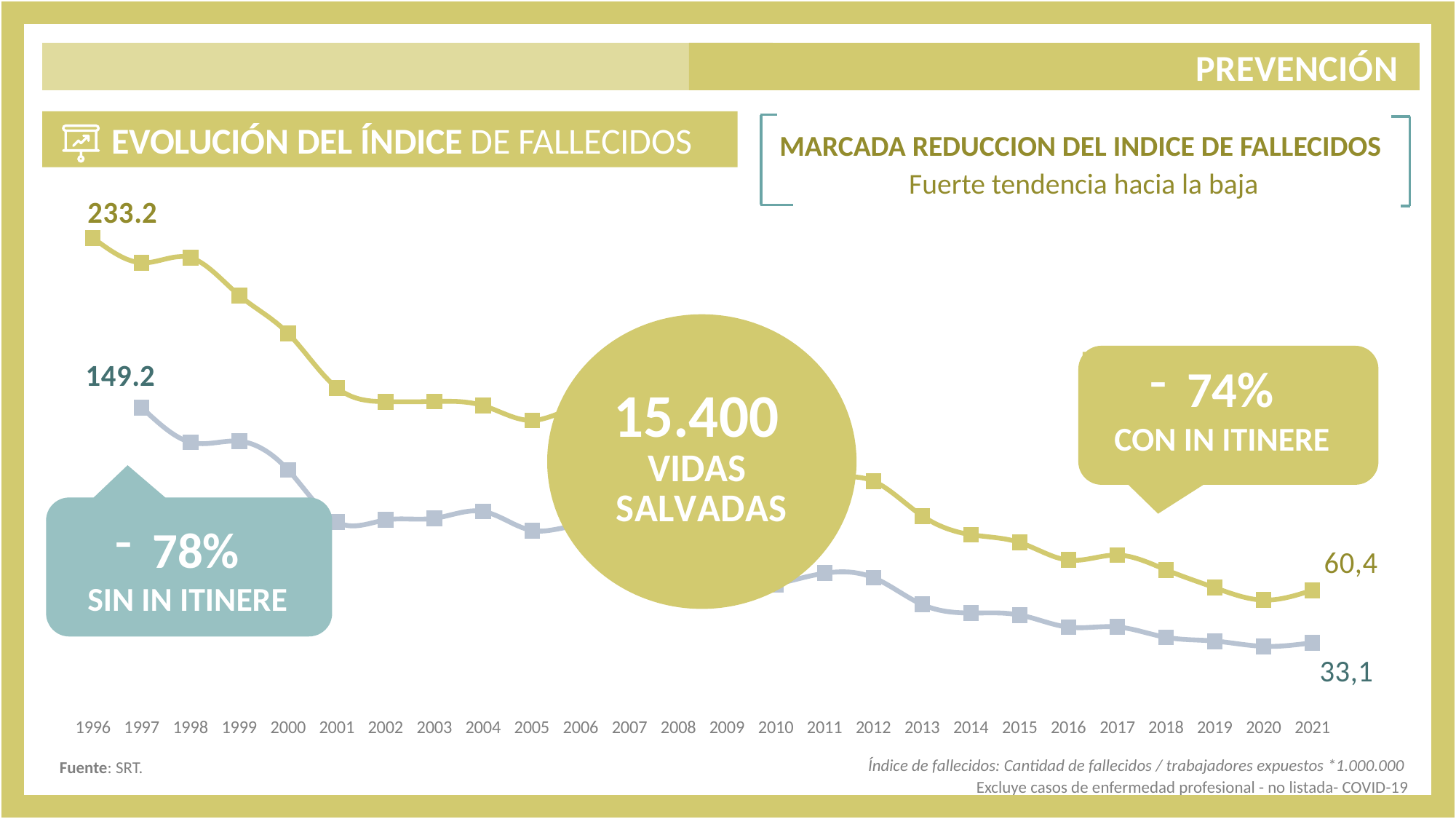
In which year does the 'con in itinere' (yellow) line reach its highest value? 1996 What is the value of the 'con in itinere' (yellow) line in 2021? 60,4 How many years are shown on the x axis of the chart? 26 How many lines are plotted on the chart? 2 In 2021, which line has the higher value, 'con in itinere' or 'sin in itinere'? con in itinere What kind of chart is shown on the slide? line chart By how much did the 'sin in itinere' index fall from 1997 (149.2) to 2021 (33,1)? 116.1 What is the value of the 'con in itinere' (yellow) line in 1996? 233.2 By how much did the 'con in itinere' index fall from 1996 (233.2) to 2021 (60,4)? 172.8 Do the values of the lines rise or fall from 1996 to 2021? fall What is the value of the 'sin in itinere' (grey) line in 2021? 33,1 What is the value of the 'sin in itinere' (grey) line in 1997? 149.2